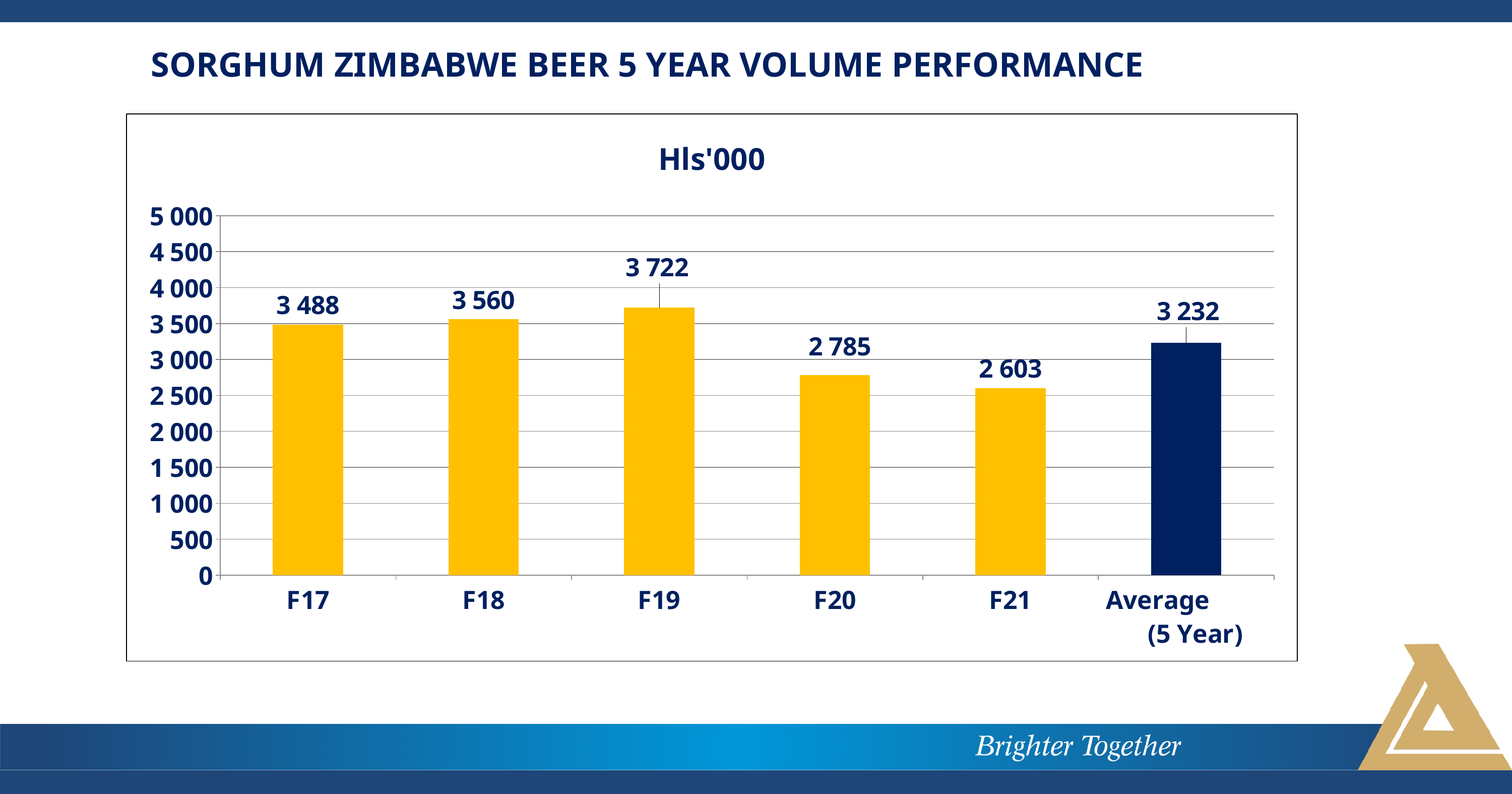
What is the difference between the F18 and F17 values? 72 How many bars are plotted on the chart? 6 What is the difference between the F19 and F21 values? 1 119 What kind of chart is shown? bar chart Which is larger, the value for F20 or the value for F17? F17 Which year has the lowest volume? F21 What is the value for F21? 2 603 What is the chart's title shown above the plot area? Hls'000 Is the value for F20 greater or less than 3 000? less What is the value shown for Average (5 Year)? 3 232 Which year has the highest volume? F19 What is the value for F19? 3 722